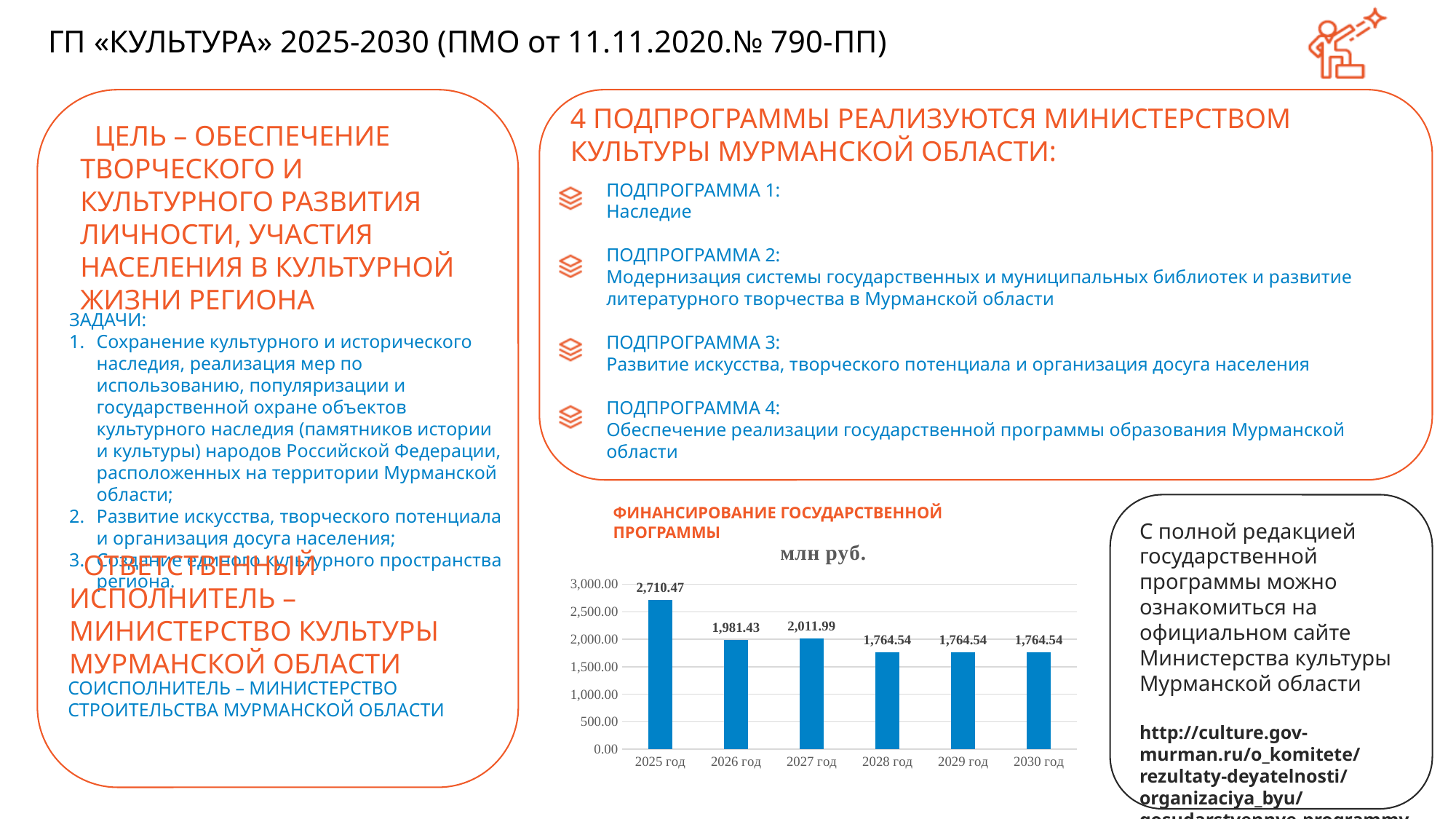
What is the value for 2027 год? 2,011.99 What is the difference between the values for 2025 год and 2026 год? 729.04 How many years are shown on the x axis of the chart? 6 What is the title shown above the chart's plot area? млн руб. What is the value for 2030 год? 1,764.54 What is the value for 2025 год? 2,710.47 Which year has the highest value? 2025 год Is the value for 2029 год greater or less than 2,000.00? less What is the difference between the values for 2027 год and 2028 год? 247.45 Is the value for 2025 год greater or less than 2,500.00? greater Which is larger, the value for 2026 год or the value for 2027 год? 2027 год What kind of chart is shown on the slide? bar chart